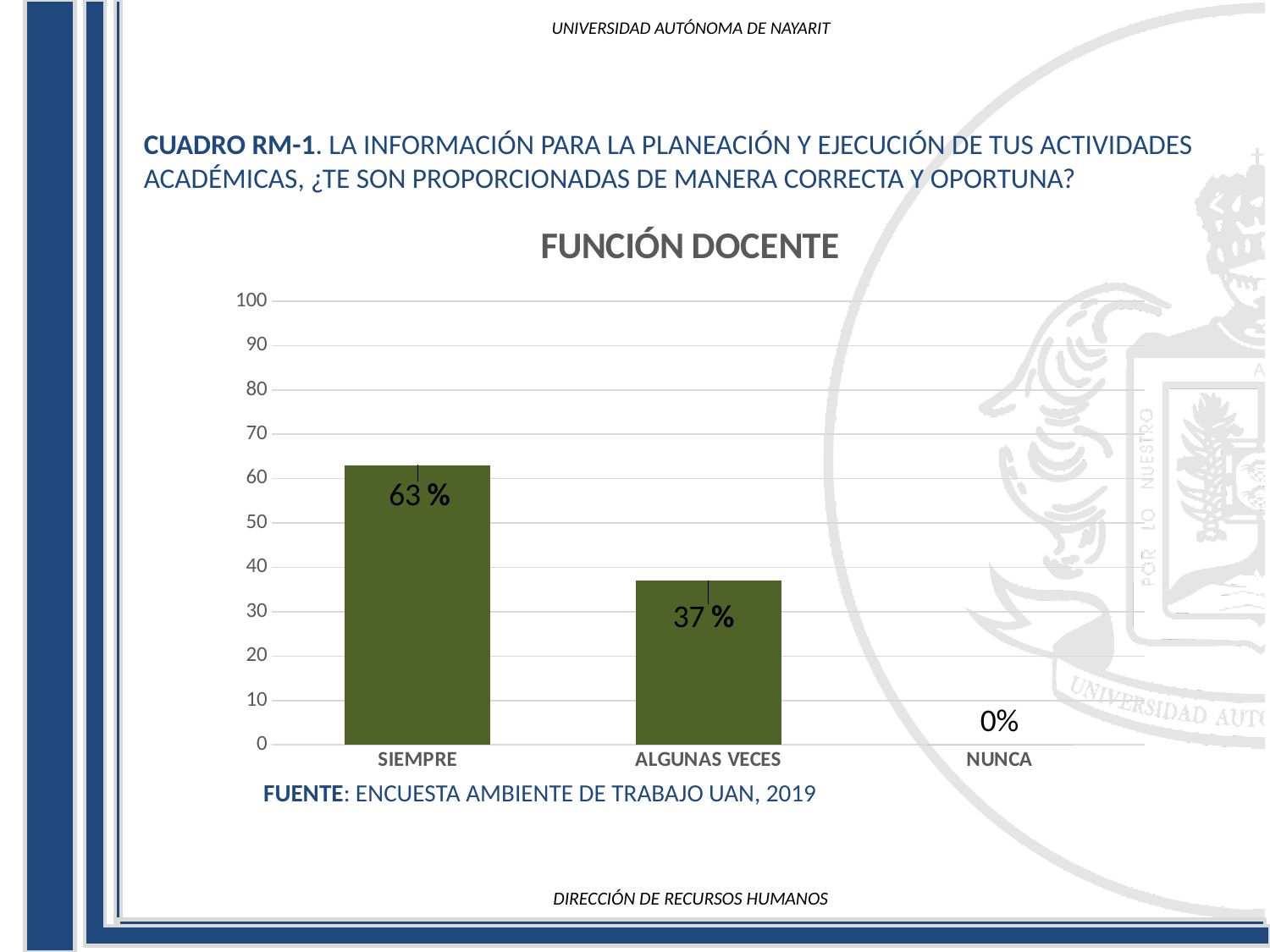
How many categories are shown on the x axis? 3 Which is larger, the value for SIEMPRE or the value for ALGUNAS VECES? SIEMPRE Which category has the lowest value? NUNCA What kind of chart is shown? bar chart What is the value for ALGUNAS VECES? 37 % Is the value for SIEMPRE greater or less than 60? greater What is the value for NUNCA? 0% Is the value for ALGUNAS VECES greater or less than 40? less What is the value for SIEMPRE? 63 % Which category has the highest value? SIEMPRE What is the difference between the values for SIEMPRE and ALGUNAS VECES? 26 % What is the title of the chart? FUNCIÓN DOCENTE